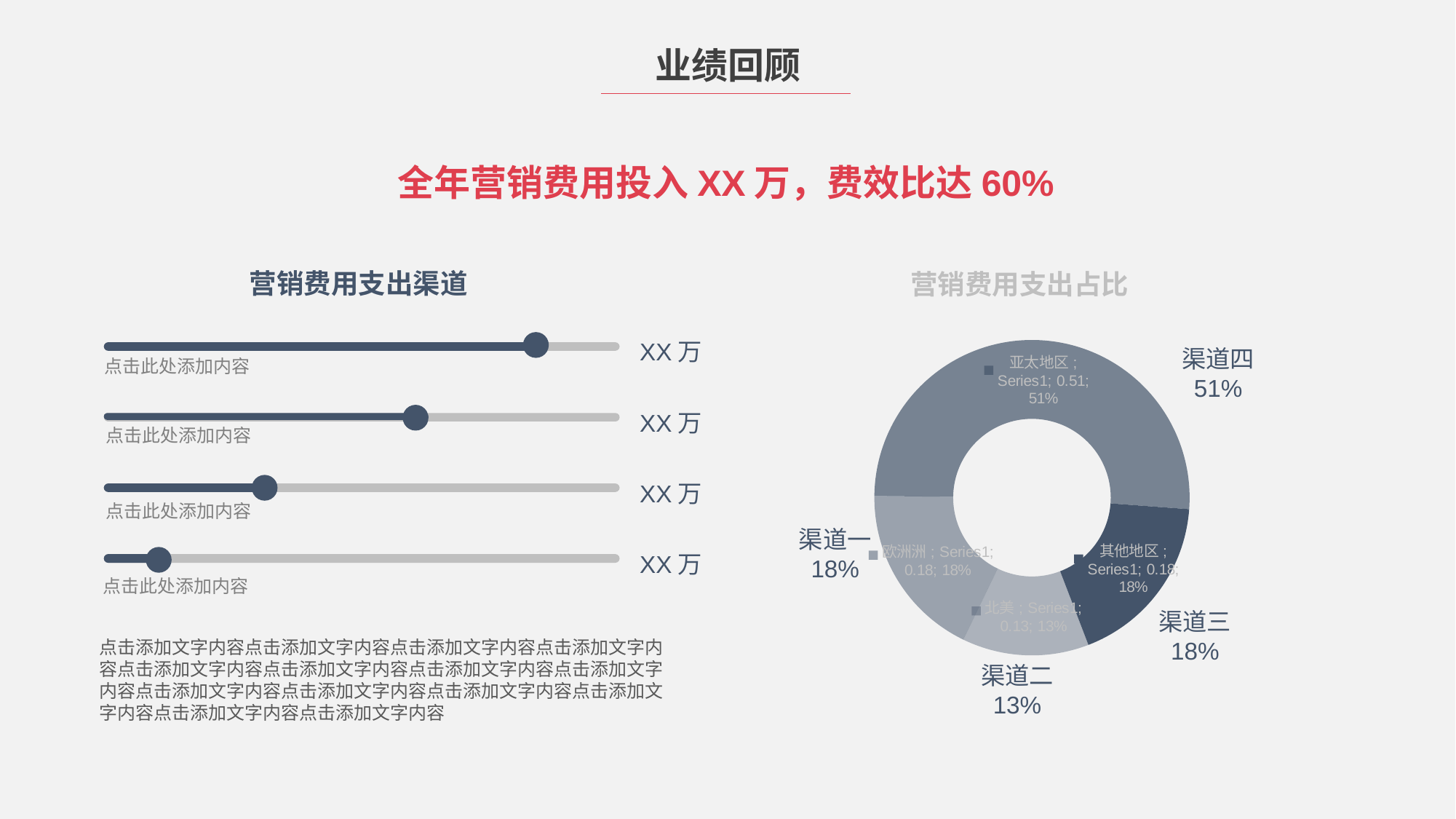
In the '营销费用支出占比' chart, what is the share for 渠道一? 18% In the '营销费用支出占比' chart, how many slices are there? 4 In the '营销费用支出占比' chart, what is the share for 渠道四? 51% What kind of chart is the '营销费用支出占比' chart? doughnut chart In the '营销费用支出占比' chart, what is the share for 渠道三? 18% In the '营销费用支出占比' chart, what is the combined share of 渠道一 and 渠道三? 36% What is the title of the doughnut chart on the right of the slide? 营销费用支出占比 In the '营销费用支出占比' chart, what is the difference in percentage points between 渠道四 and 渠道二? 38 In the '营销费用支出占比' chart, what is the share for 渠道二? 13% In the '营销费用支出占比' chart, which slice has the largest share? 渠道四 In the '营销费用支出占比' chart, which slice has the smallest share? 渠道二 In the '营销费用支出占比' chart, which is larger, 渠道一 or 渠道二? 渠道一